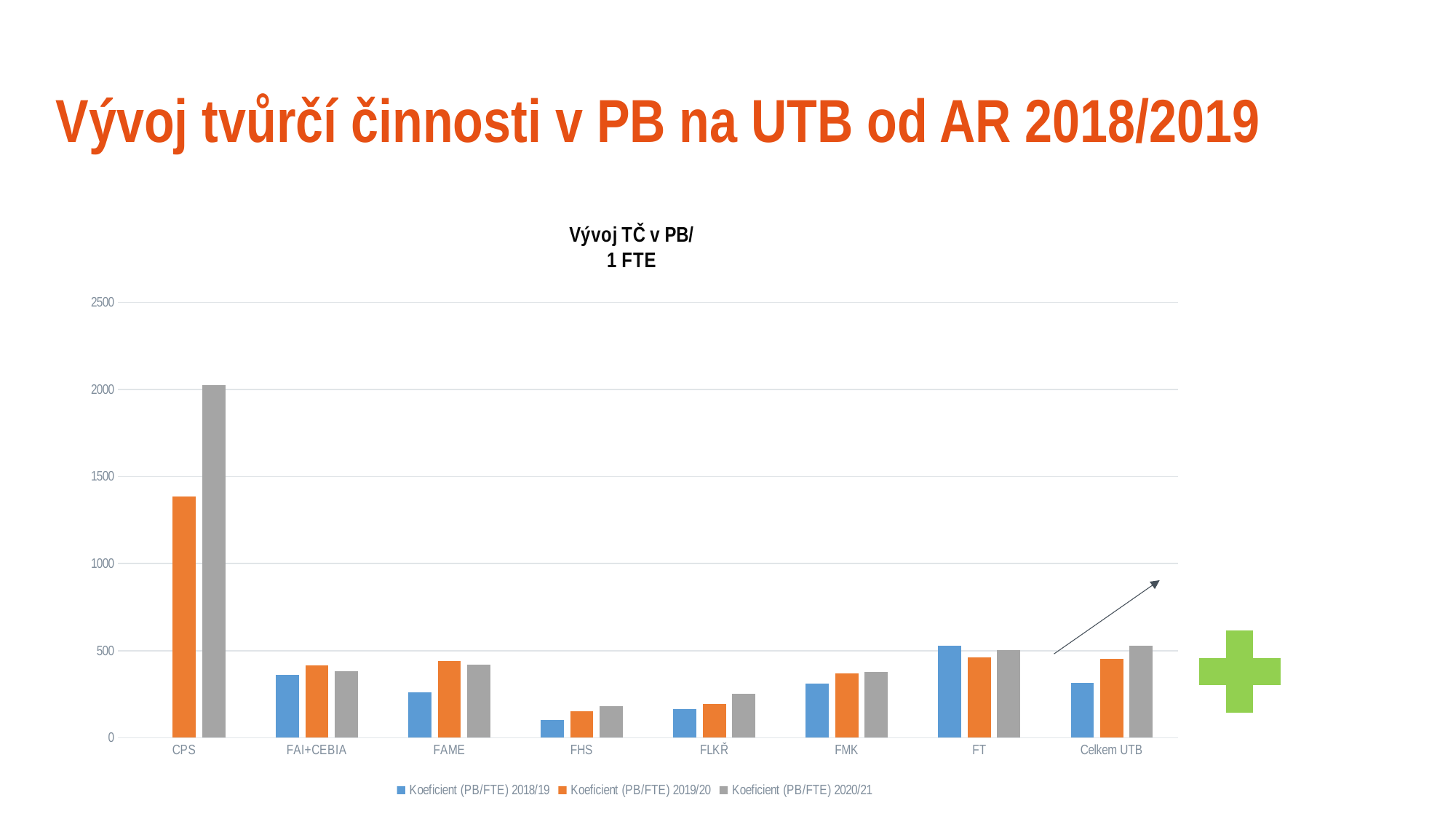
What is the title of the chart? Vývoj TČ v PB/ 1 FTE Which category has the lowest value for Koeficient (PB/FTE) 2018/19? FHS Which category has the lowest value for Koeficient (PB/FTE) 2020/21? FHS How many categories are shown on the x axis? 8 What kind of chart is shown on the slide? Bar chart Which is larger for Koeficient (PB/FTE) 2018/19: FHS or FLKŘ? FLKŘ How many series does the legend list? 3 For Celkem UTB, do the values rise or fall from 2018/19 to 2020/21? rise Which category has the highest value for Koeficient (PB/FTE) 2020/21? CPS Is the value for CPS in Koeficient (PB/FTE) 2019/20 greater or less than 1500? less Is the value for CPS in Koeficient (PB/FTE) 2020/21 greater or less than 1500? greater Is the value for FHS in Koeficient (PB/FTE) 2018/19 greater or less than 500? less